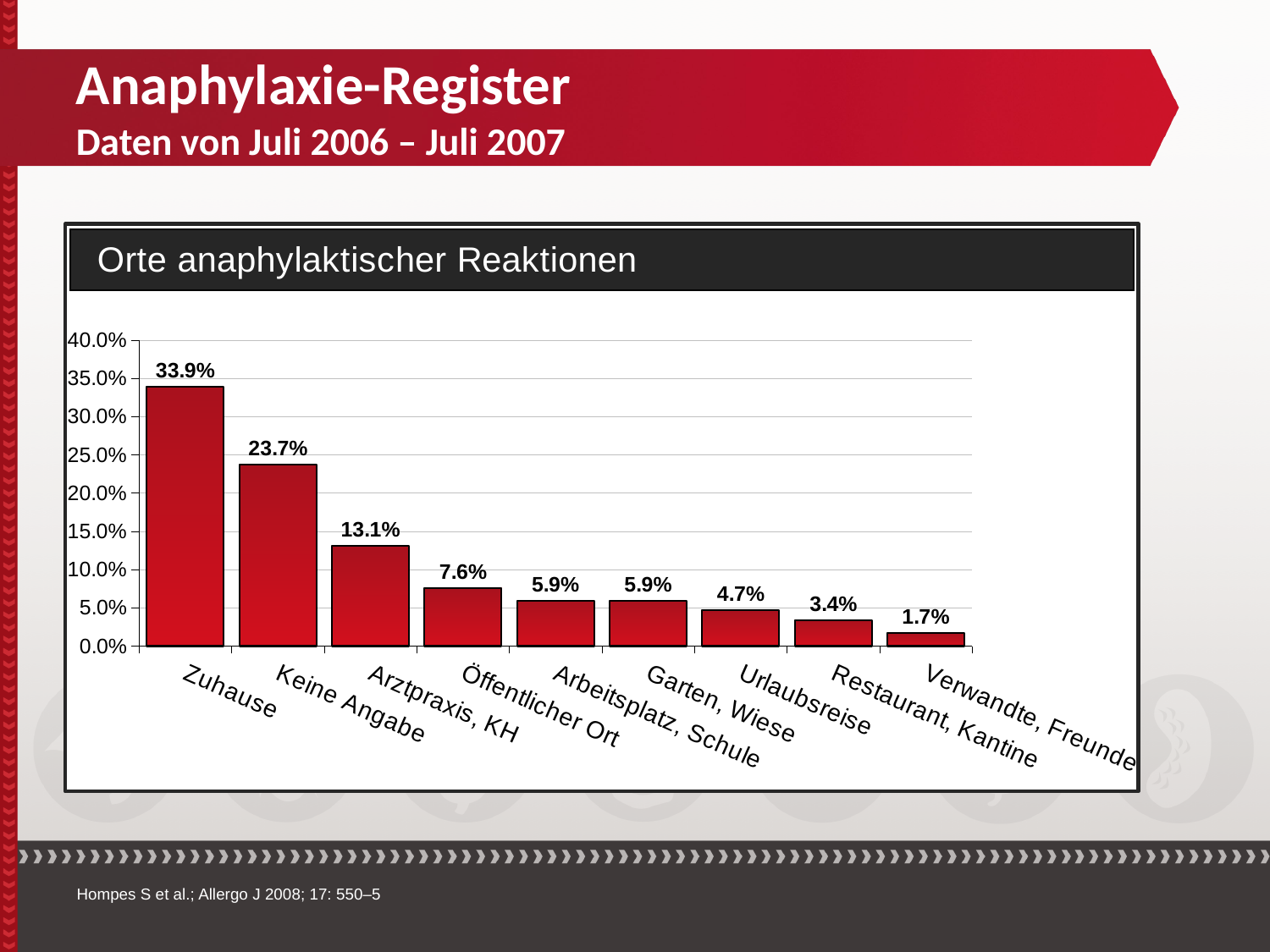
What is the difference between the values for Zuhause and Keine Angabe? 10.2% Which category has the lowest value? Verwandte, Freunde What is the value for Arztpraxis, KH? 13.1% What kind of chart is shown? bar chart Which category has the highest value? Zuhause What is the title of the chart? Orte anaphylaktischer Reaktionen Which is larger, the value for Öffentlicher Ort or the value for Restaurant, Kantine? Öffentlicher Ort What is the value for Urlaubsreise? 4.7% What is the value for Zuhause? 33.9% Is the value for Keine Angabe greater or less than 20.0%? greater Do the values rise or fall from left to right along the x axis? fall How many categories are shown in the chart? 9